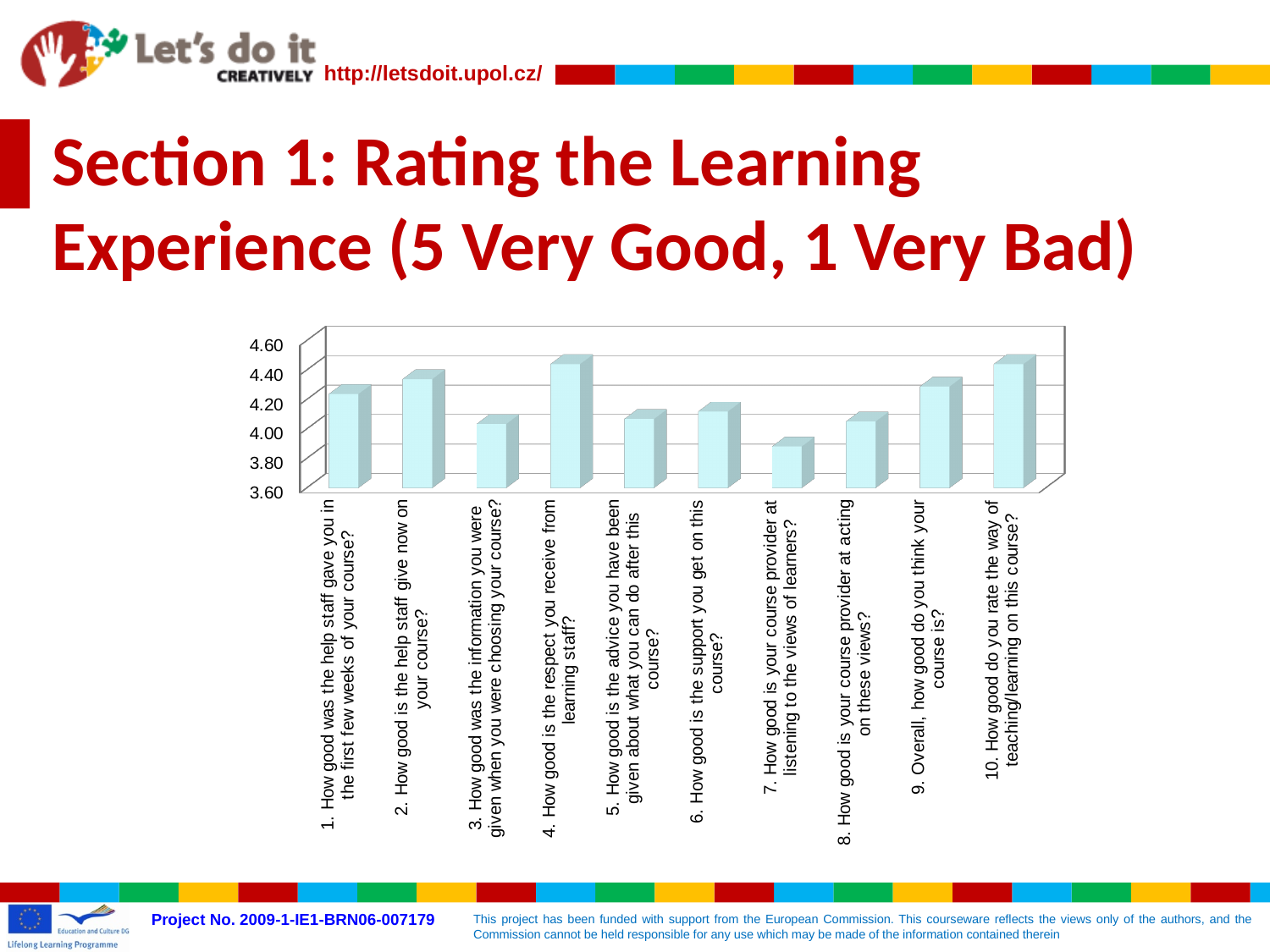
What kind of chart is shown on the slide? bar chart What is the highest value shown on the vertical axis of the chart? 4.60 What is the lowest value shown on the vertical axis of the chart? 3.60 Which question received the lowest rating in the chart? 7. How good is your course provider at listening to the views of learners? Is the value for question 7 (course provider listening to the views of learners) greater or less than 4.00? less Is the value for question 9 (overall, how good do you think your course is) greater or less than 4.20? greater Which has the higher rating: question 2 (help staff give now) or question 3 (information given when choosing the course)? question 2 How many questions (categories) are plotted in the chart? 10 Which has the higher rating: question 7 (course provider listening to learners' views) or question 9 (overall course rating)? question 9